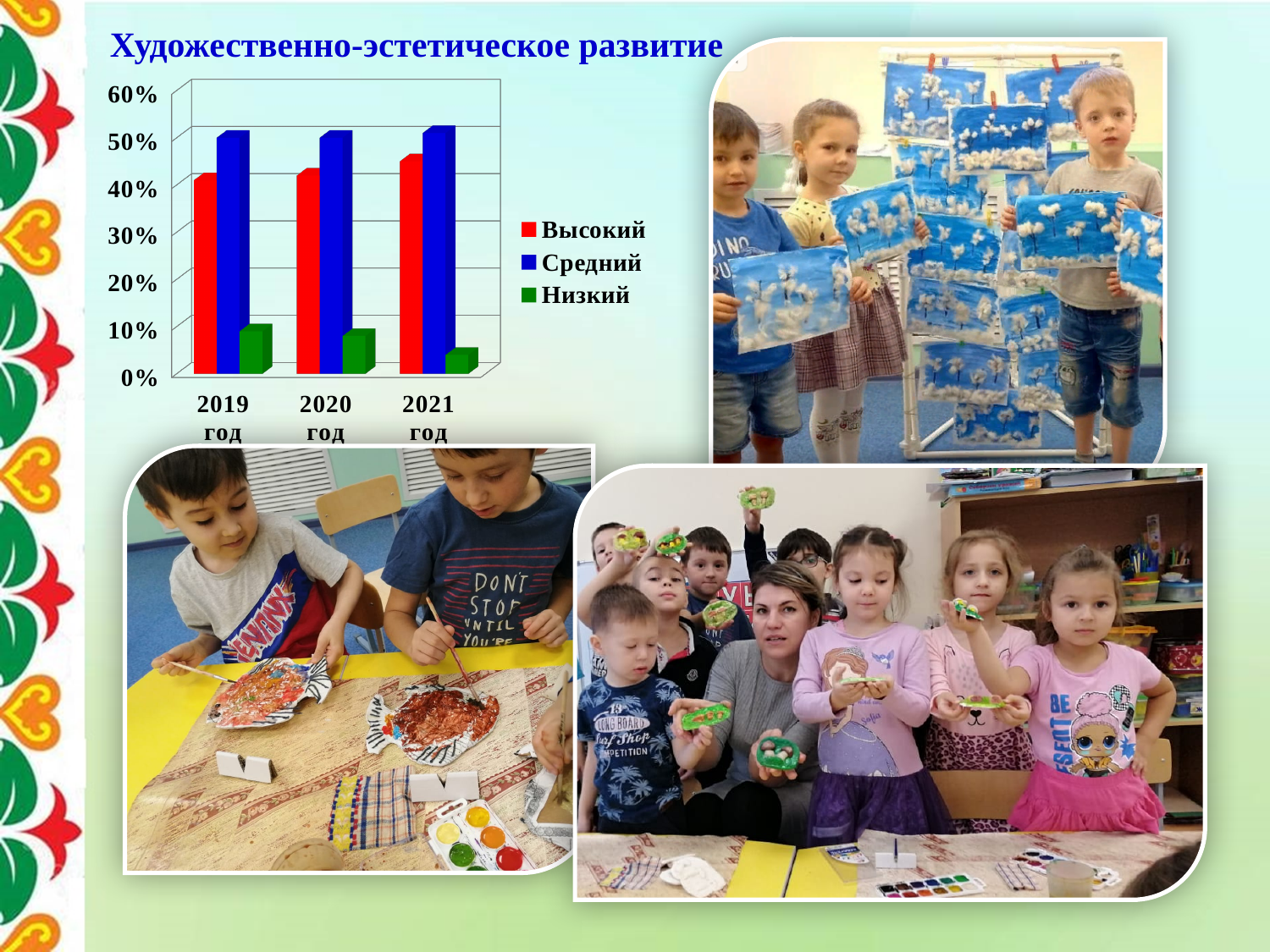
How many series does the chart legend list? 3 Which series has the highest value in 2021 год? Средний Is the value for Высокий in 2019 год greater or less than 30%? greater What kind of chart is shown on the slide? bar chart How many year categories are shown on the x axis of the chart? 3 Do the values for Низкий rise or fall from 2019 год to 2021 год? fall Which series has the lowest value in 2019 год? Низкий What is the title above the chart? Художественно-эстетическое развитие In 2020 год, which is larger: Высокий or Средний? Средний Is the value for Низкий in 2021 год greater or less than 10%? less Which colour represents the series Низкий in the chart? green Is the value for Средний in 2019 год greater or less than 40%? greater